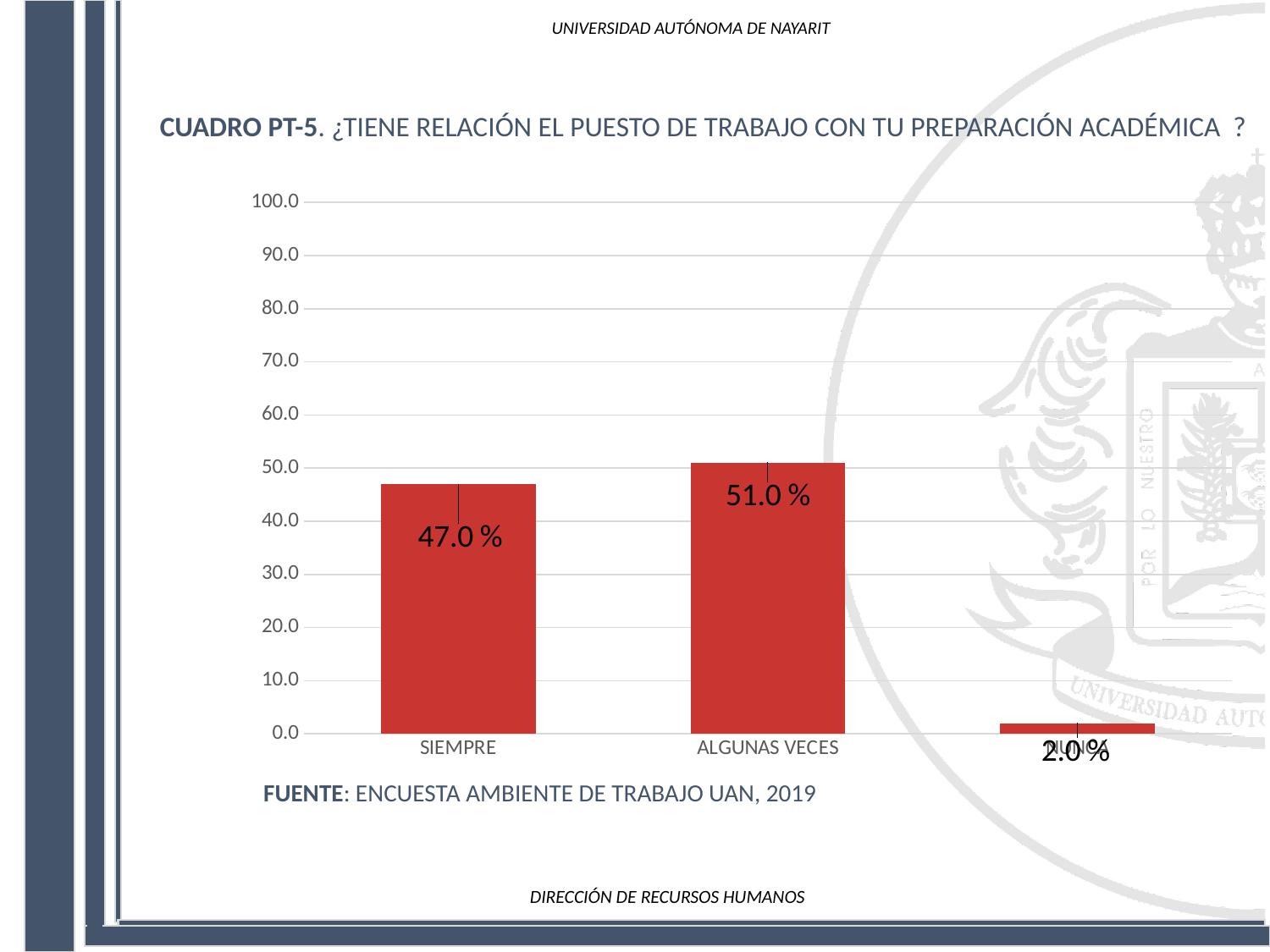
Which category has the highest value? ALGUNAS VECES Which is larger, the value for SIEMPRE or the value for ALGUNAS VECES? ALGUNAS VECES What is the value shown on the rightmost (third) bar? 2.0 % What is the value for SIEMPRE? 47.0 % Is the value for ALGUNAS VECES greater or less than 50.0? greater How many categories are shown on the chart? 3 Is the value for SIEMPRE greater or less than 50.0? less What is the value for ALGUNAS VECES? 51.0 % What is the difference between the values for ALGUNAS VECES and SIEMPRE? 4.0 % What kind of chart is shown on the slide? bar chart What is the lowest value shown on the chart? 2.0 % What source is cited below the chart? ENCUESTA AMBIENTE DE TRABAJO UAN, 2019